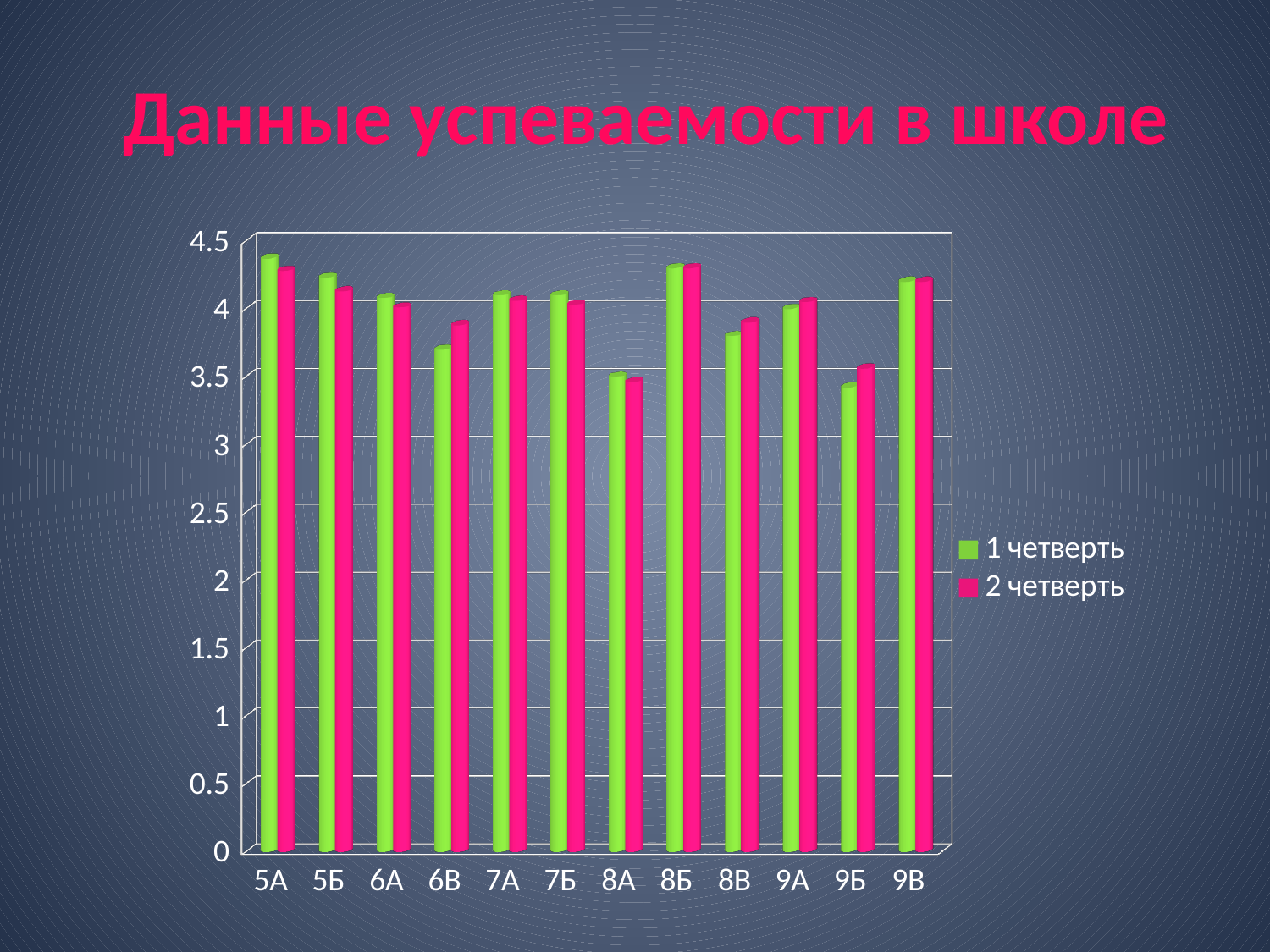
Is the value for 5А in '1 четверть' greater or less than 4? greater Is the value for 8В in '2 четверть' greater or less than 4? less Which class has the larger value in '1 четверть': 5А or 6В? 5А How many series does the chart legend list? 2 What kind of chart is shown on the slide? bar chart How many classes (categories) are shown on the x axis of the chart? 12 Is the value for 8Б in '2 четверть' greater or less than 4? greater What is the title of the chart slide? Данные успеваемости в школе Which colour represents the series '2 четверть' in the chart? pink